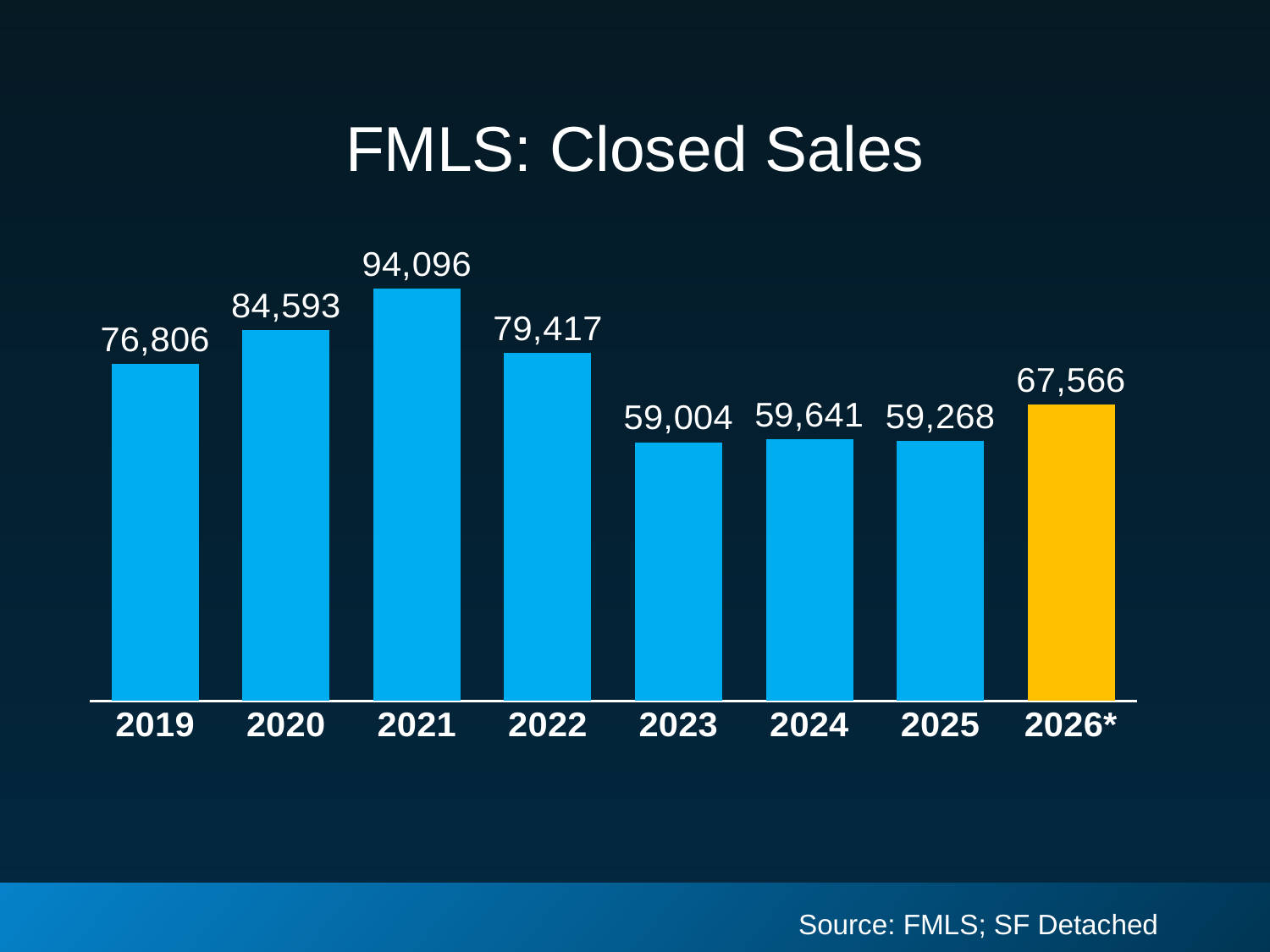
Which is larger, the value for 2019 or the value for 2022? 2022 How many years are shown on the chart? 8 What is the title of the chart? FMLS: Closed Sales Which year has the lowest closed sales? 2023 What is the difference between the values for 2022 and 2023? 20,413 What is the value for 2023? 59,004 What is the difference between the values for 2021 and 2020? 9,503 Do the values rise or fall from 2021 to 2023? fall What kind of chart is this? bar chart What is the value for 2021? 94,096 Which year has the highest closed sales? 2021 What is the value for 2026*? 67,566